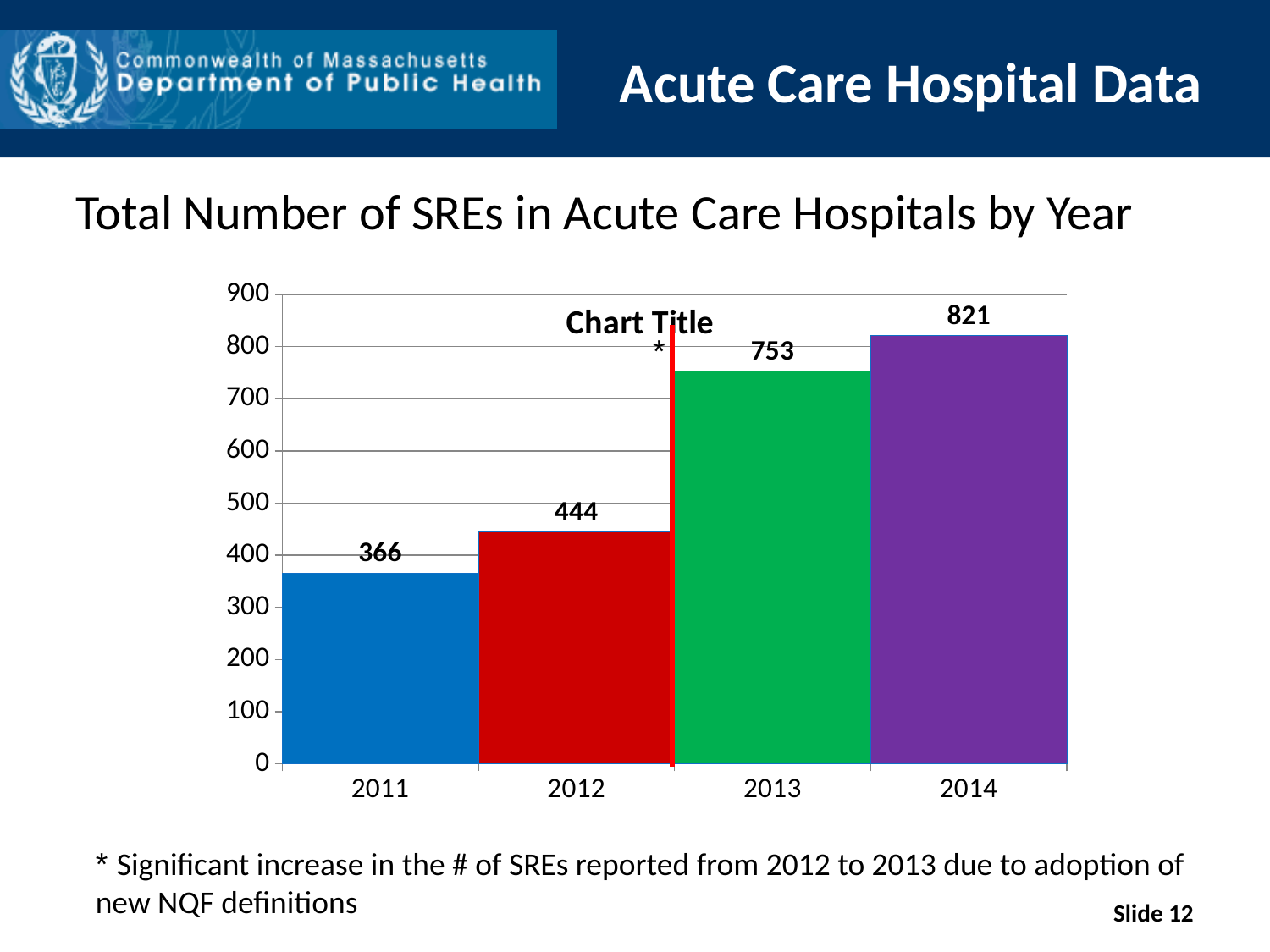
How many years are shown on the x axis of the chart? 4 What is the total number of SREs in acute care hospitals in 2011? 366 Which year has more SREs, 2012 or 2013? 2013 What is the value shown for 2013? 753 What is the total number of SREs in acute care hospitals in 2014? 821 Do the number of SREs rise or fall from 2011 to 2014? Rise What kind of chart is shown on the slide? Bar chart Which year has the highest number of SREs? 2014 What is the title shown above the chart on the slide? Total Number of SREs in Acute Care Hospitals by Year What is the difference in the number of SREs between 2014 and 2011? 455 Which year has the lowest number of SREs? 2011 What is the difference in the number of SREs between 2013 and 2012? 309